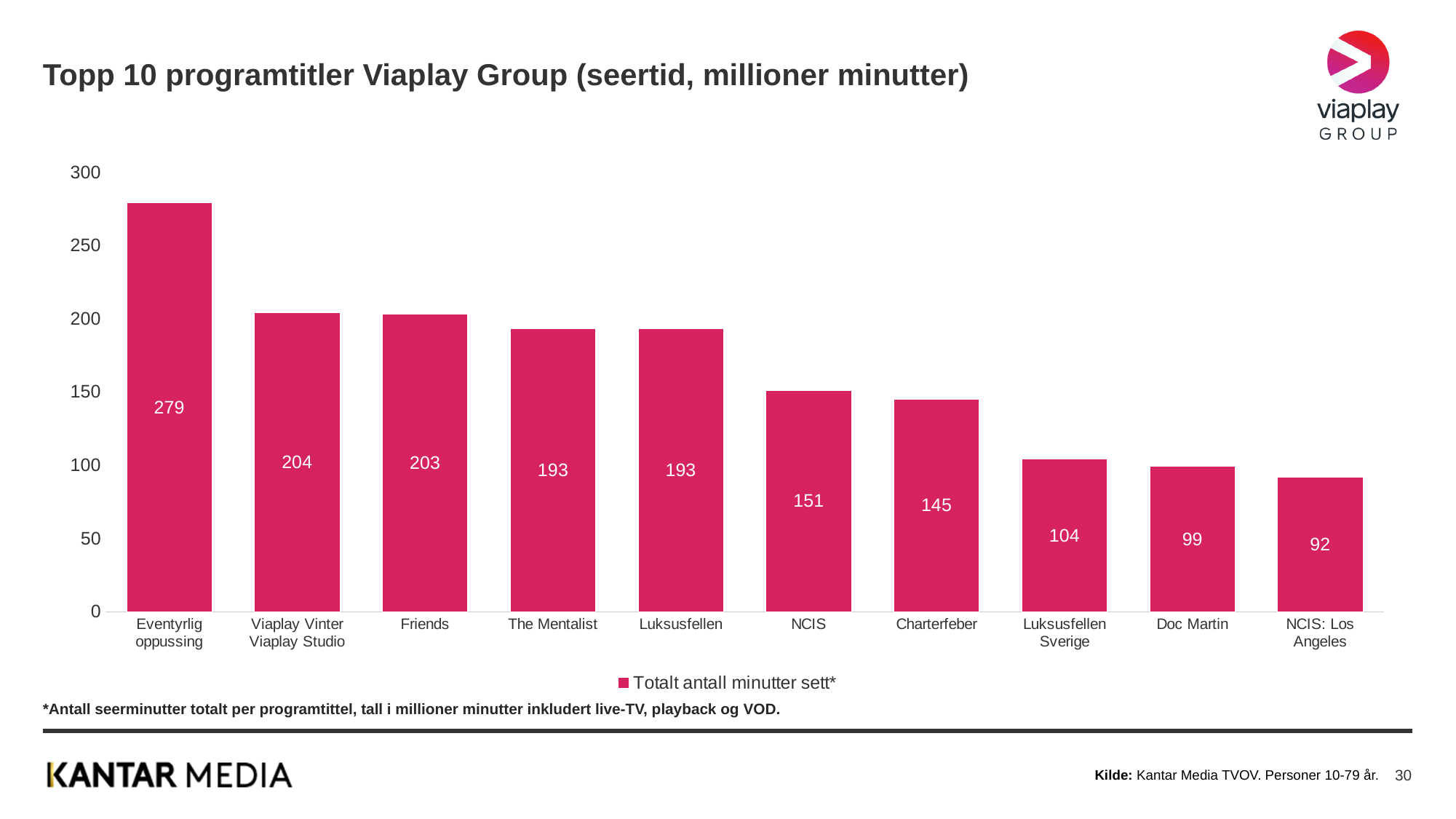
What is the difference between the values for NCIS and Charterfeber? 6 Which program title has the lowest value? NCIS: Los Angeles Which program title has the highest value? Eventyrlig oppussing What is the legend entry for the series shown in the chart? Totalt antall minutter sett* How many program titles are shown in the chart? 10 What is the value for NCIS? 151 Which is larger, the value for Luksusfellen Sverige or the value for NCIS: Los Angeles? Luksusfellen Sverige What is the difference between the values for Eventyrlig oppussing and Viaplay Vinter Viaplay Studio? 75 Is the value for Charterfeber greater or less than 150? less What kind of chart is shown on the slide? bar chart What is the value for Eventyrlig oppussing? 279 What is the value for Doc Martin? 99